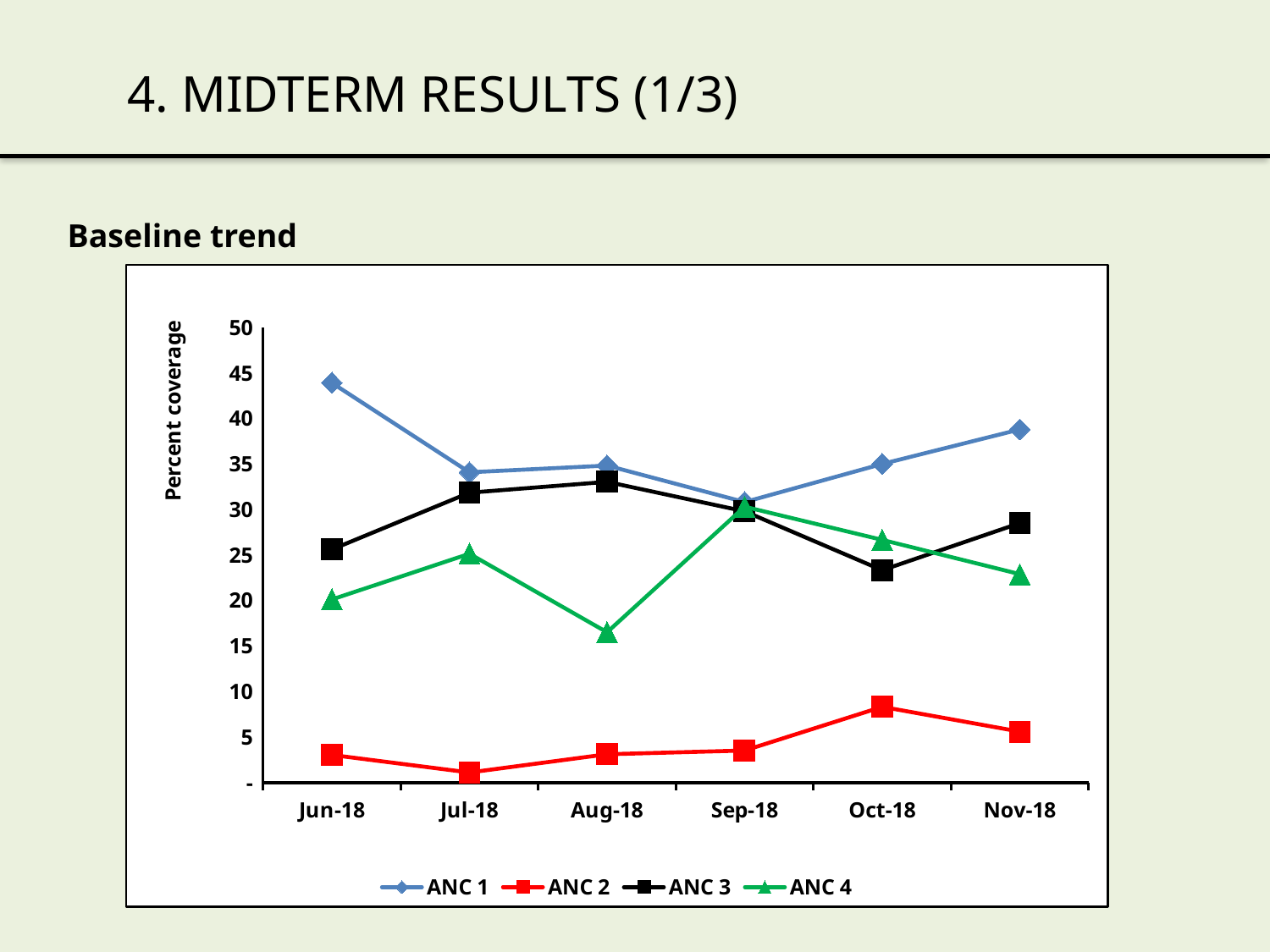
Is the value for ANC 2 in Oct-18 greater or less than 10? less How many series does the legend list? 4 Is the value for ANC 4 in Aug-18 greater or less than 20? less Does the ANC 1 line rise or fall from Jun-18 to Jul-18? fall What is the label on the vertical axis? Percent coverage Is the value for ANC 1 in Jun-18 greater or less than 40? greater In which month is ANC 2 at its highest? Oct-18 In which month is ANC 1 at its highest? Jun-18 What kind of chart is shown on the slide? line chart In which month is ANC 4 at its lowest? Aug-18 How many months are plotted along the x axis? 6 In Jun-18, which is larger, ANC 1 or ANC 3? ANC 1